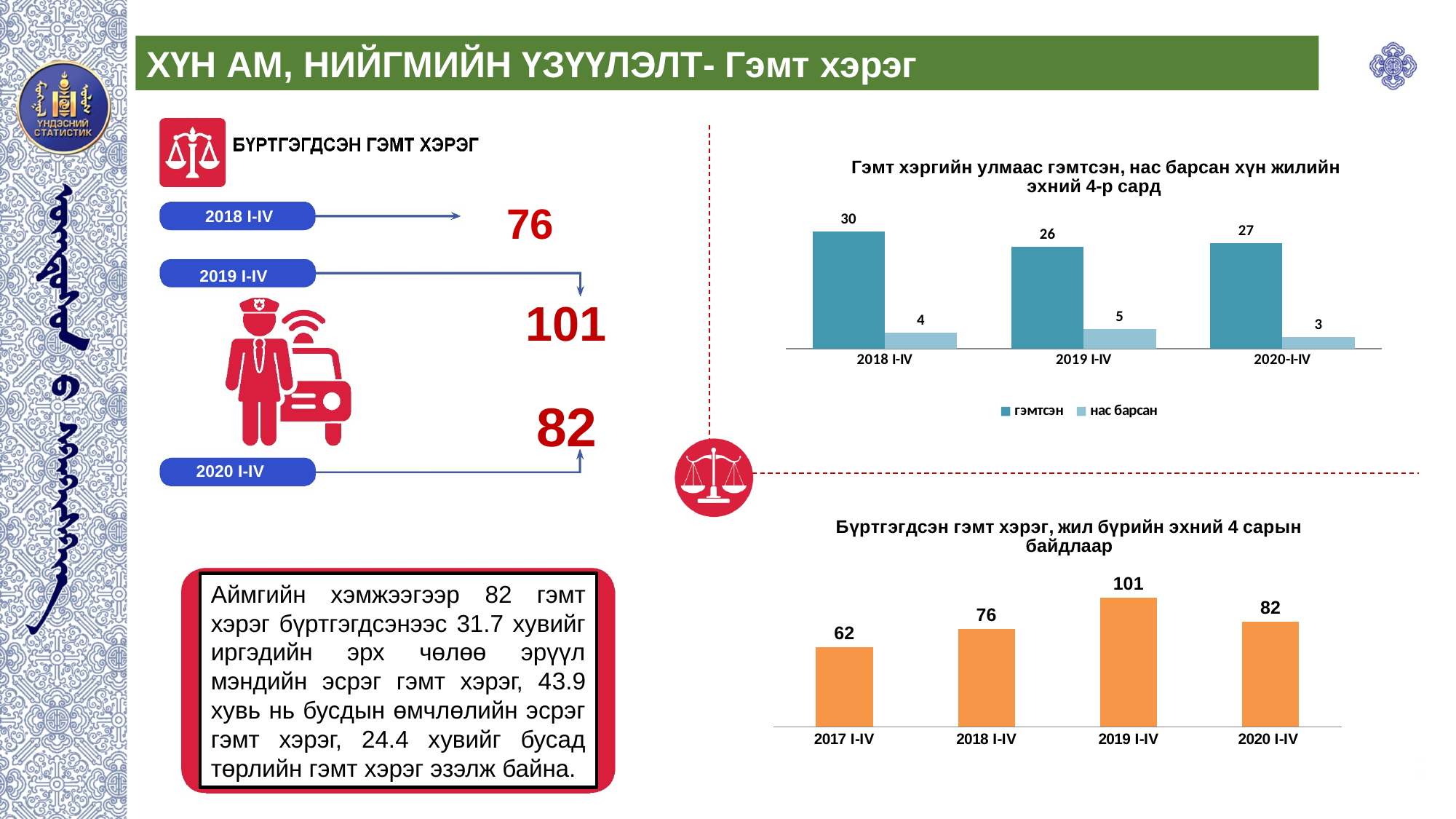
In the top-right chart (Гэмт хэргийн улмаас гэмтсэн, нас барсан хүн), what is the difference between гэмтсэн and нас барсан in 2020-IV? 24 In the bottom-right chart (Бүртгэгдсэн гэмт хэрэг), what is the difference between 2019 I-IV and 2020 I-IV? 19 In the top-right chart (Гэмт хэргийн улмаас гэмтсэн, нас барсан хүн), what is the value for гэмтсэн in 2018 I-IV? 30 In the bottom-right chart (Бүртгэгдсэн гэмт хэрэг), how many categories are shown on the x axis? 4 In the top-right chart (Гэмт хэргийн улмаас гэмтсэн, нас барсан хүн), which is larger for гэмтсэн: 2018 I-IV or 2019 I-IV? 2018 I-IV In the top-right chart (Гэмт хэргийн улмаас гэмтсэн, нас барсан хүн), which year has the lowest value for нас барсан? 2020-I-IV In the bottom-right chart (Бүртгэгдсэн гэмт хэрэг), do the values rise or fall from 2017 I-IV to 2019 I-IV? Rise In the top-right chart (Гэмт хэргийн улмаас гэмтсэн, нас барсан хүн), what is the value for нас барсан in 2019 I-IV? 5 In the bottom-right chart (Бүртгэгдсэн гэмт хэрэг), what is the value for 2017 I-IV? 62 In the bottom-right chart (Бүртгэгдсэн гэмт хэрэг), which year has the highest value? 2019 I-IV In the top-right chart (Гэмт хэргийн улмаас гэмтсэн, нас барсан хүн), how many series does the legend list? 2 What kind of chart is the bottom-right chart (Бүртгэгдсэн гэмт хэрэг)? Bar chart